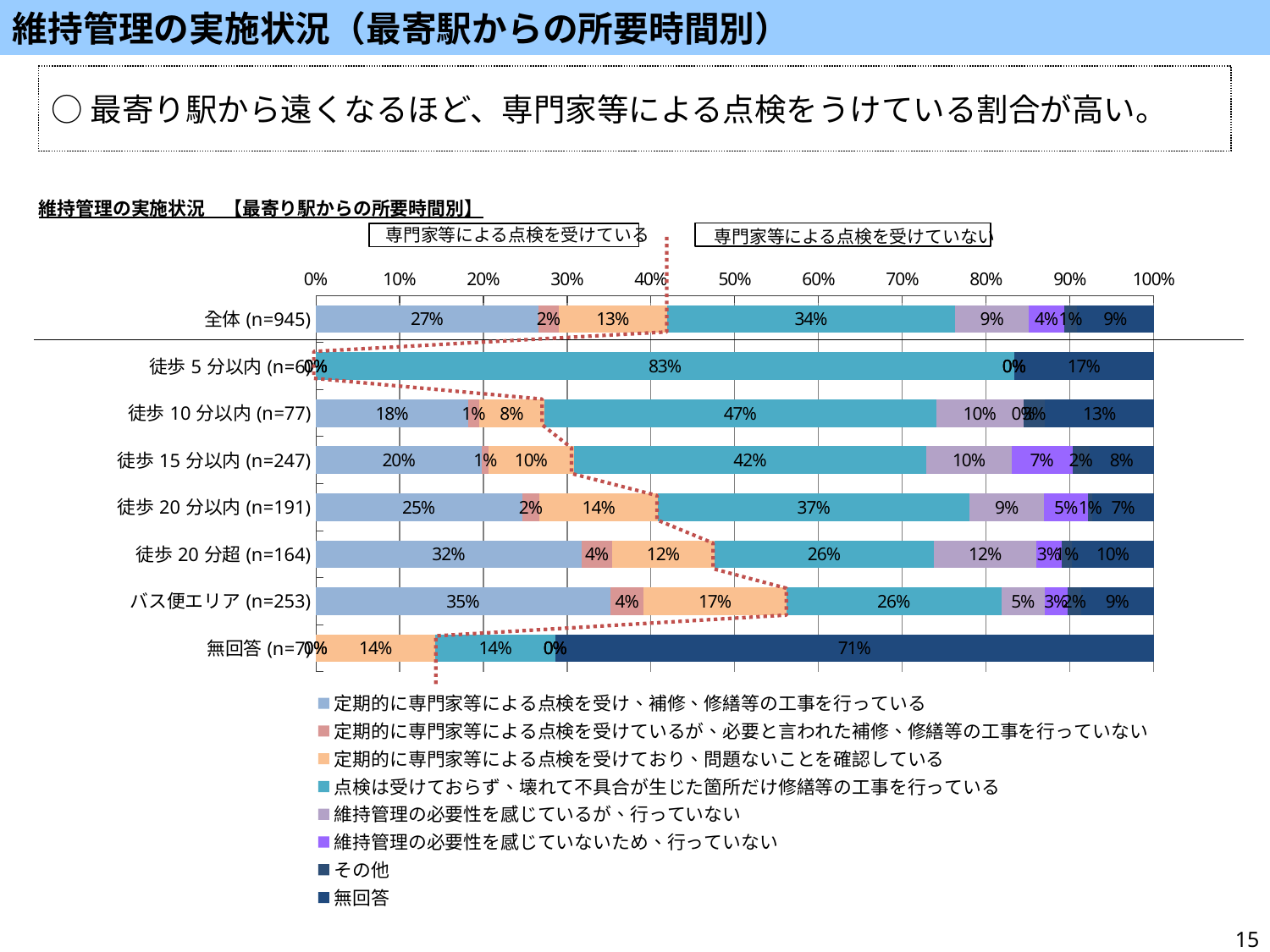
What is the difference between バス便エリア (n=253) and 徒歩 10 分以内 (n=77) in the series 定期的に専門家等による点検を受け、補修、修繕等の工事を行っている? 17 percentage points What is the value for 無回答 (n=7) in the series 無回答? 71% How many categories (rows) are plotted in the chart? 8 What is the value for バス便エリア (n=253) in the series 定期的に専門家等による点検を受け、補修、修繕等の工事を行っている? 35% What is the value for 全体 (n=945) in the series 定期的に専門家等による点検を受け、補修、修繕等の工事を行っている? 27% What is the sample size (n) shown for the 全体 category? 945 What is the value for 徒歩 15 分以内 (n=247) in the series 点検は受けておらず、壊れて不具合が生じた箇所だけ修繕等の工事を行っている? 42% Which is larger for the series 定期的に専門家等による点検を受け、補修、修繕等の工事を行っている: 徒歩 20 分超 (n=164) or 徒歩 15 分以内 (n=247)? 徒歩 20 分超 (n=164) What is the value for 徒歩 5 分以内 (n=6) in the series 点検は受けておらず、壊れて不具合が生じた箇所だけ修繕等の工事を行っている? 83% What kind of chart is shown on the slide? Stacked bar chart Which category has the highest value for 定期的に専門家等による点検を受け、補修、修繕等の工事を行っている? バス便エリア (n=253) How many series does the legend list? 8